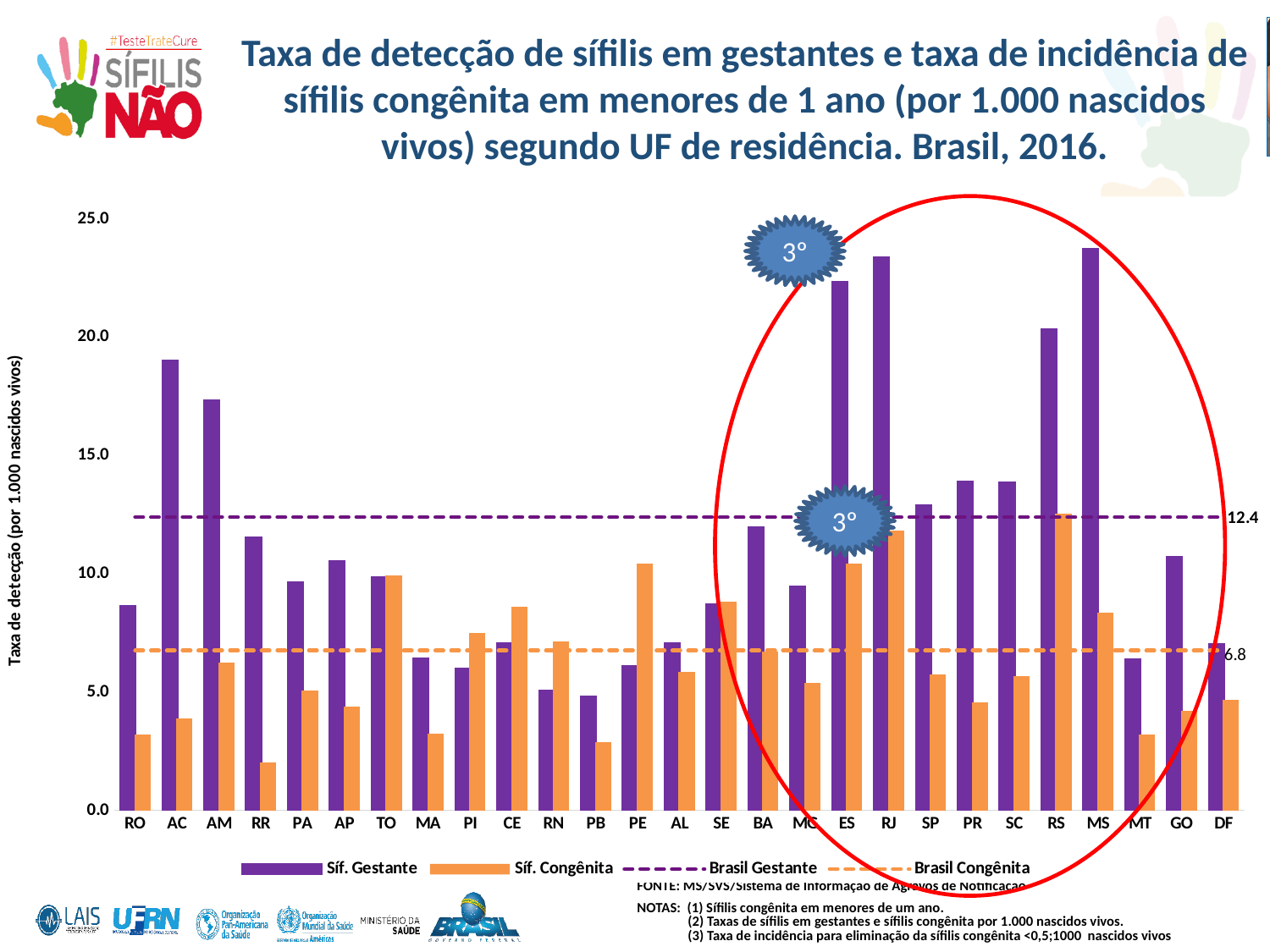
How many entries does the legend list? 4 Is the Síf. Gestante value for ES greater or less than 20.0? greater What kind of chart is shown on the slide? combination bar and line chart What value is printed for the Brasil Gestante dashed line? 12.4 What value is printed for the Brasil Congênita dashed line? 6.8 Which is larger, the Síf. Gestante value for AC or for AM? AC Which UF has the lowest Síf. Congênita value? RR For PE, which is larger, the Síf. Gestante value or the Síf. Congênita value? Síf. Congênita Is the Síf. Gestante value for AC greater or less than 15.0? greater How many UFs are shown on the x axis? 27 Is the Síf. Gestante value for MA greater or less than 10.0? less